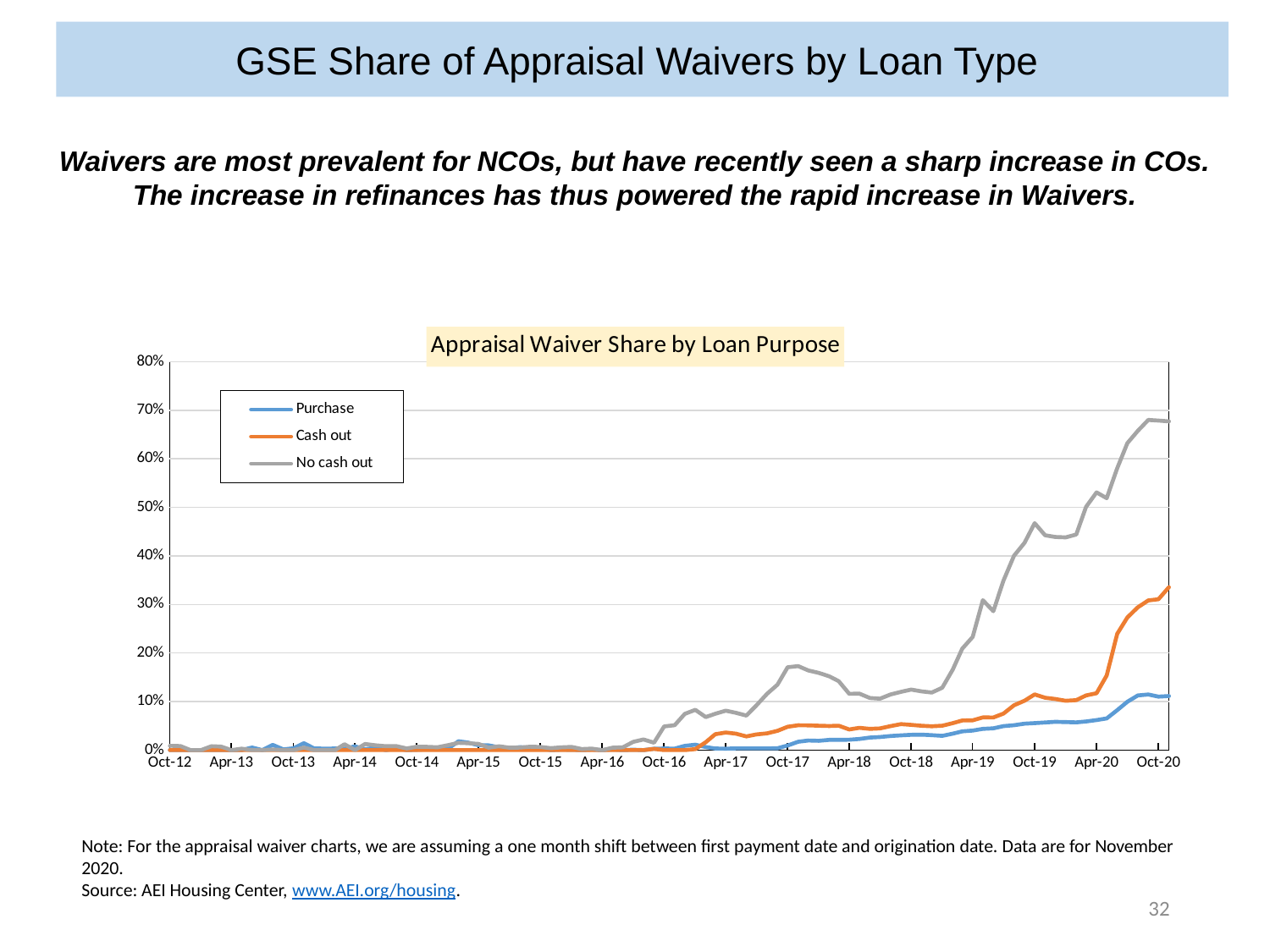
Is the value for Purchase at Oct-20 greater or less than 20%? less Is the value for No cash out at Oct-17 greater or less than 20%? less Which series has the highest value at Oct-20? No cash out Is the value for No cash out at Oct-20 greater or less than 60%? greater At Oct-20, which is larger: the Cash out value or the Purchase value? Cash out Does the No cash out series rise or fall between Apr-19 and Oct-20? Rise Which series is shown in gray in the chart? No cash out What type of chart is shown on the slide? Line chart Which series has the lowest value at Oct-20? Purchase What is the title of the chart? Appraisal Waiver Share by Loan Purpose How many series does the legend of the chart list? 3